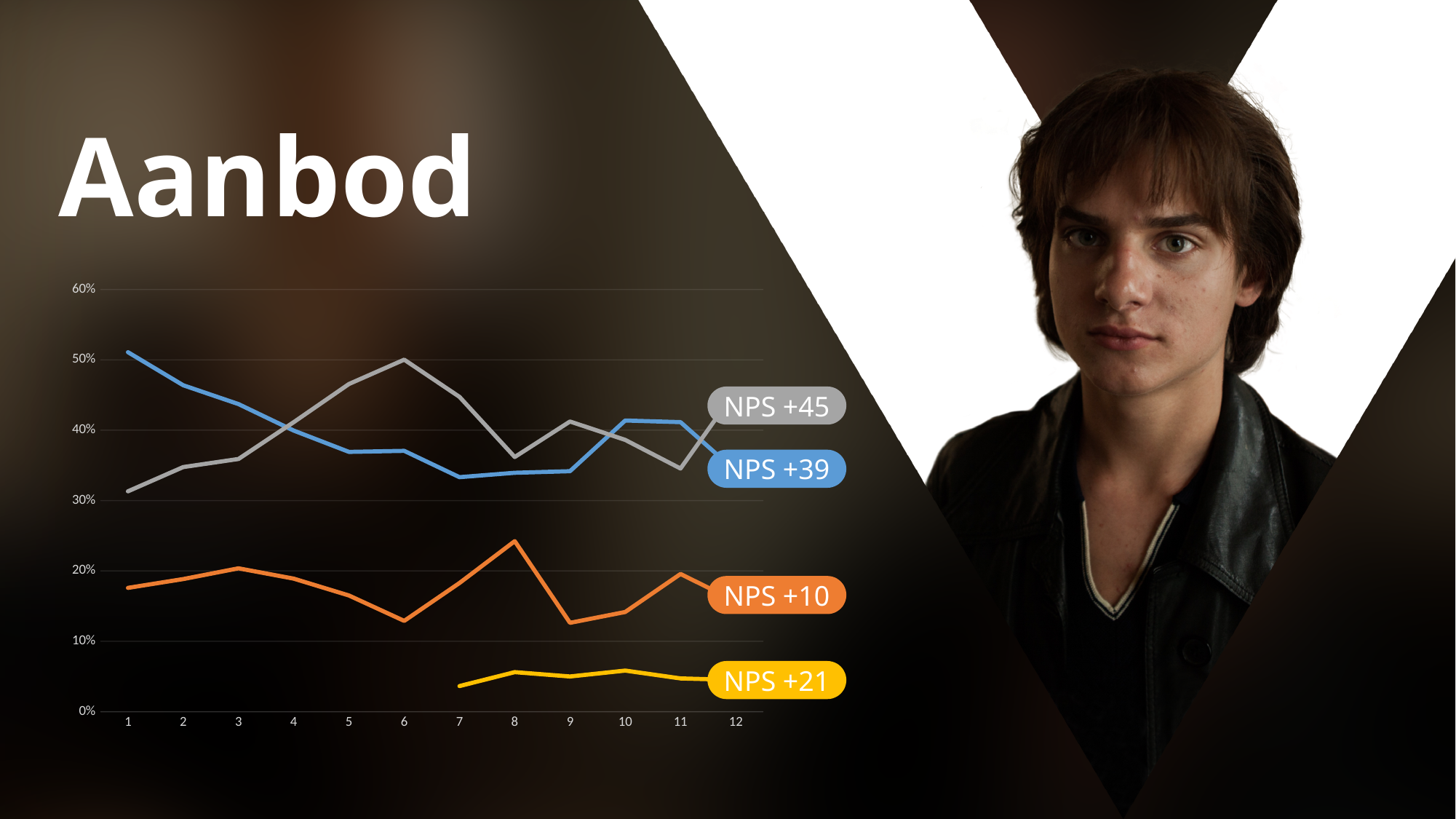
At point 6, which line is higher: the gray line or the blue line? the gray line Is the value of the yellow line at point 8 greater or less than 10%? less Is the value of the orange line at point 8 greater or less than 20%? greater Which line is the lowest on the chart across all points? the yellow line (NPS +21) How many lines are plotted on the chart? 4 Is the value of the blue line at point 1 greater or less than 40%? greater How many points are labelled along the x axis of the chart? 12 What label is shown at the end of the gray line? NPS +45 What kind of chart is shown on the slide? line chart At point 1, which line is higher: the blue line or the gray line? the blue line Does the blue line rise or fall from point 1 to point 7? fall